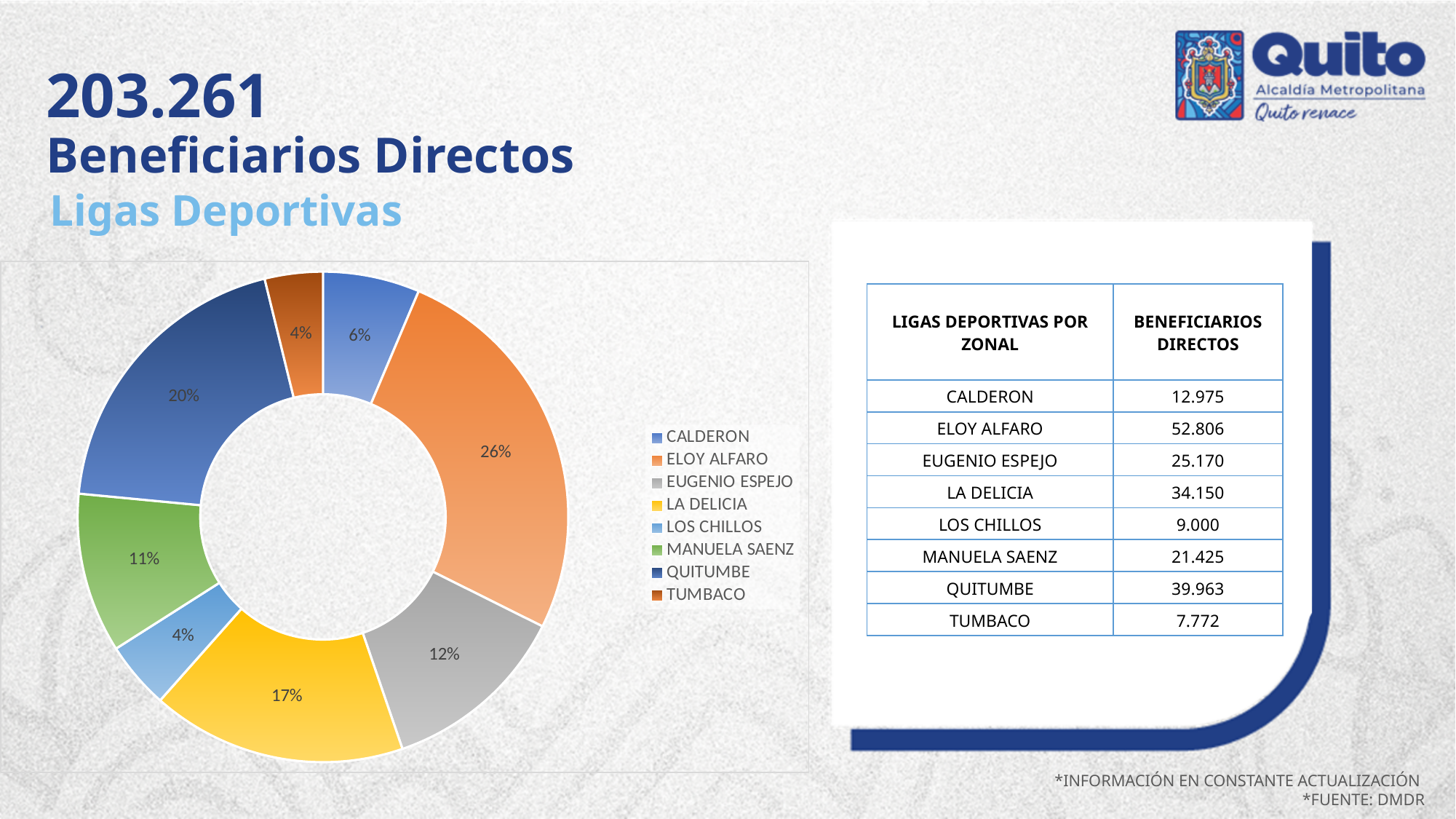
What percentage share does ELOY ALFARO have in the doughnut chart? 26% Which zonal has the largest share in the doughnut chart? ELOY ALFARO What percentage is shown for LA DELICIA in the doughnut chart? 17% How many slices does the doughnut chart have? 8 Which has the larger share in the doughnut chart, LA DELICIA or EUGENIO ESPEJO? LA DELICIA What colour is the ELOY ALFARO slice in the doughnut chart? orange What percentage is shown for MANUELA SAENZ in the doughnut chart? 11% How many entries does the legend of the doughnut chart list? 8 What percentage is shown for QUITUMBE in the doughnut chart? 20% What is the difference in percentage points between ELOY ALFARO and QUITUMBE in the doughnut chart? 6 What percentage is shown for CALDERON in the doughnut chart? 6% What kind of chart is shown on the slide? doughnut chart